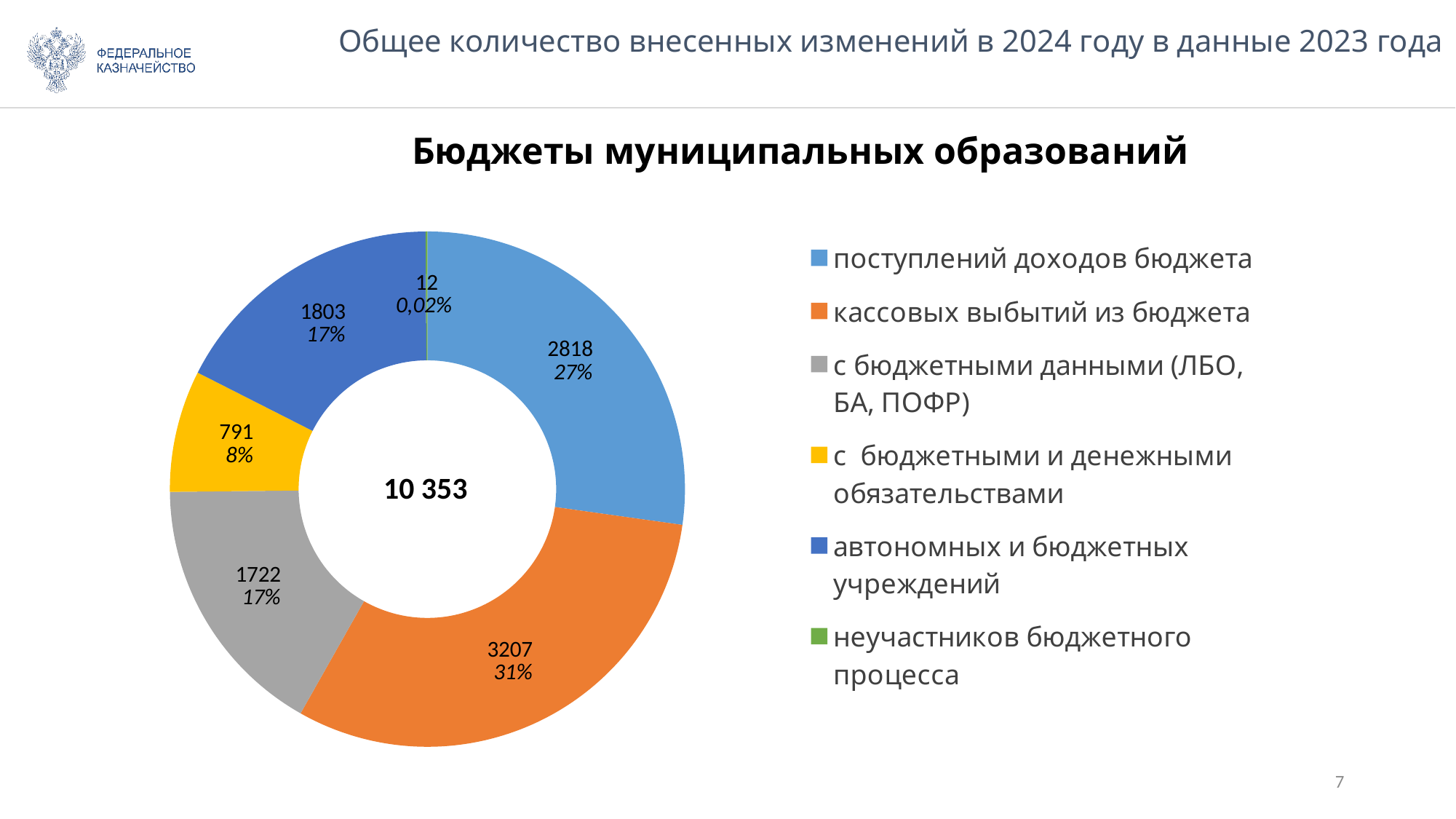
What is the value for «с бюджетными и денежными обязательствами»? 791 What share of the chart does «кассовых выбытий из бюджета» represent? 31% What is the value for «неучастников бюджетного процесса»? 12 Which is larger: the value for «автономных и бюджетных учреждений» or for «с бюджетными данными (ЛБО, БА, ПОФР)»? автономных и бюджетных учреждений What kind of chart is shown on the slide? doughnut chart What is the total shown in the centre of the chart? 10 353 Which category has the smallest value in the chart? неучастников бюджетного процесса Which category has the largest value in the chart? кассовых выбытий из бюджета How many categories does the chart show? 6 What is the value for «кассовых выбытий из бюджета» in the chart «Бюджеты муниципальных образований»? 3207 What is the difference between the values for «кассовых выбытий из бюджета» and «поступлений доходов бюджета»? 389 What is the value for «поступлений доходов бюджета»? 2818